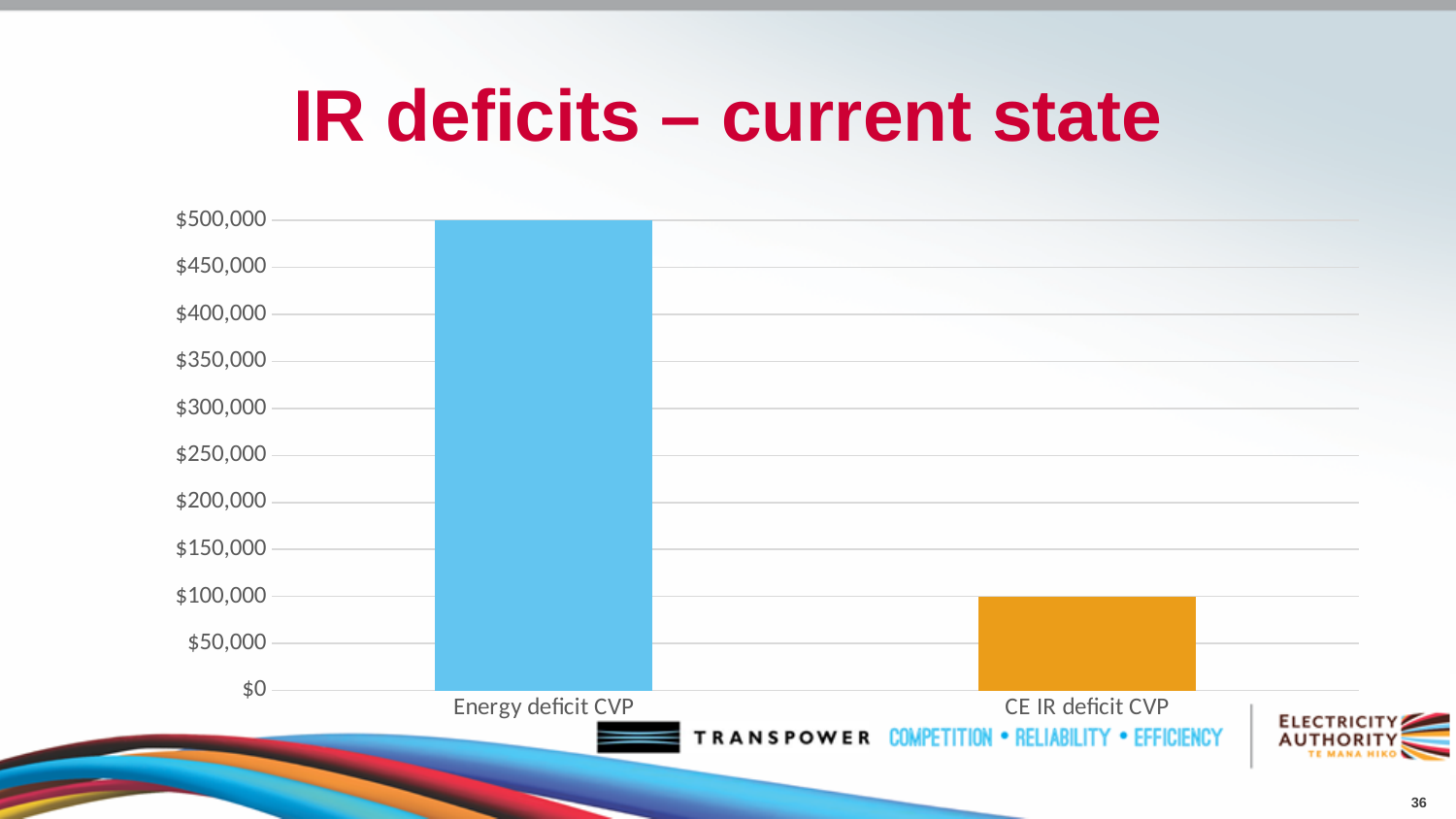
Which is larger, Energy deficit CVP or CE IR deficit CVP? Energy deficit CVP What is the difference between the Energy deficit CVP and CE IR deficit CVP values? $400,000 What is the title of the slide containing the chart? IR deficits – current state What is the value for Energy deficit CVP? $500,000 Is the value for CE IR deficit CVP greater or less than $150,000? less Is the value for Energy deficit CVP greater or less than $450,000? greater Which category has the lowest value? CE IR deficit CVP Which category has the highest value? Energy deficit CVP What colour is the bar for CE IR deficit CVP? orange How many categories are shown on the chart? 2 What kind of chart is shown on the slide? bar chart What is the value for CE IR deficit CVP? $100,000